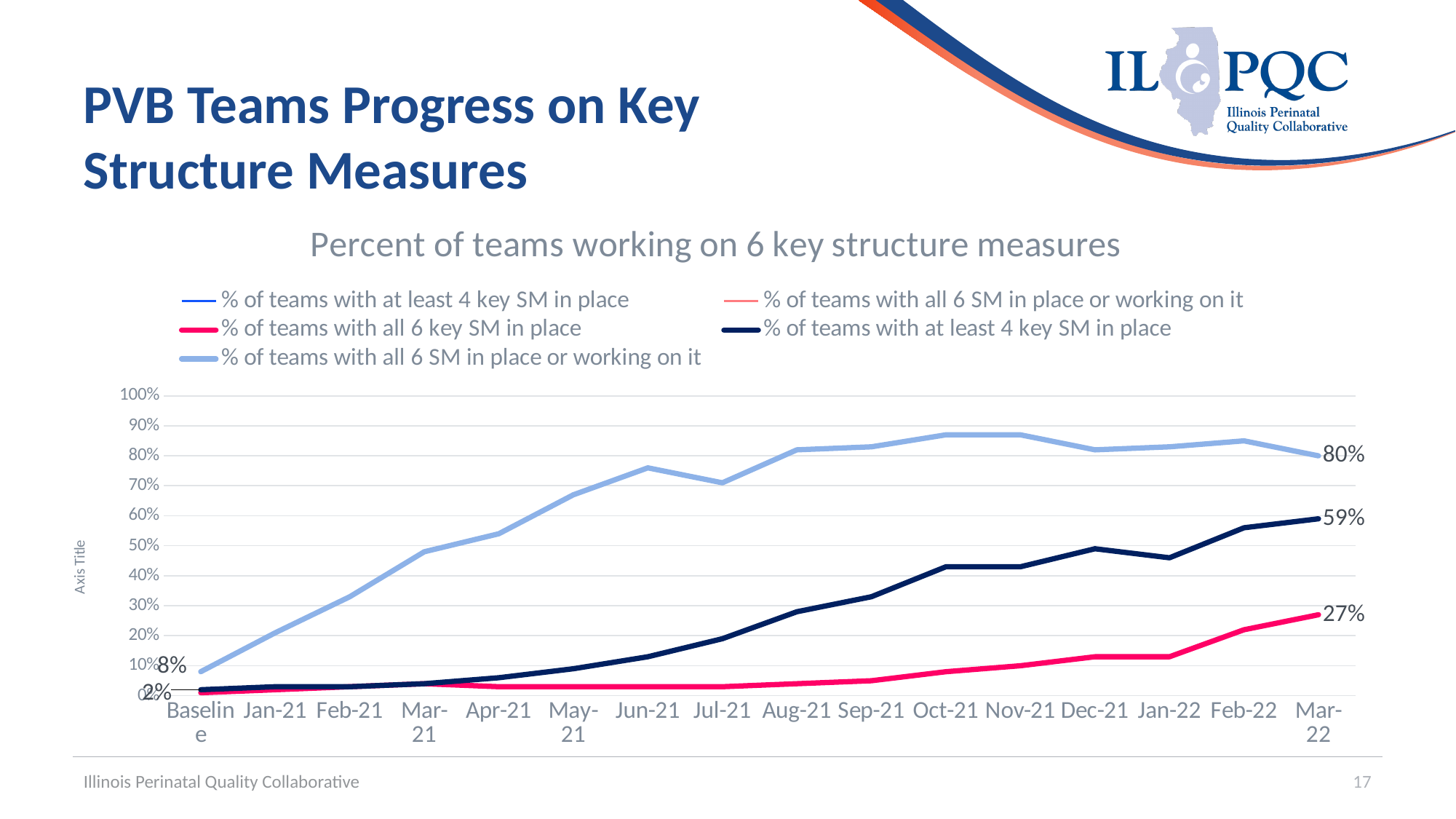
What is the value for '% of teams with at least 4 key SM in place' at Mar-22? 59% At Mar-22, what is the difference between '% of teams with at least 4 key SM in place' and '% of teams with all 6 key SM in place'? 32 percentage points What kind of chart is shown on the slide? Line chart What is the value for '% of teams with all 6 key SM in place' at Mar-22? 27% What is the value for '% of teams with all 6 SM in place or working on it' at Baseline? 8% What is the value for '% of teams with all 6 SM in place or working on it' at Mar-22? 80% Is the value for '% of teams with at least 4 key SM in place' at Jun-21 greater or less than 20%? less Does the '% of teams with all 6 SM in place or working on it' line rise or fall overall from Baseline to Mar-22? Rise How many time points are shown on the x axis of the chart? 16 At Mar-22, what is the difference between '% of teams with all 6 SM in place or working on it' and '% of teams with at least 4 key SM in place'? 21 percentage points Is the value for '% of teams with all 6 SM in place or working on it' at Oct-21 greater or less than 80%? greater At Mar-22, which is larger: '% of teams with at least 4 key SM in place' or '% of teams with all 6 key SM in place'? % of teams with at least 4 key SM in place